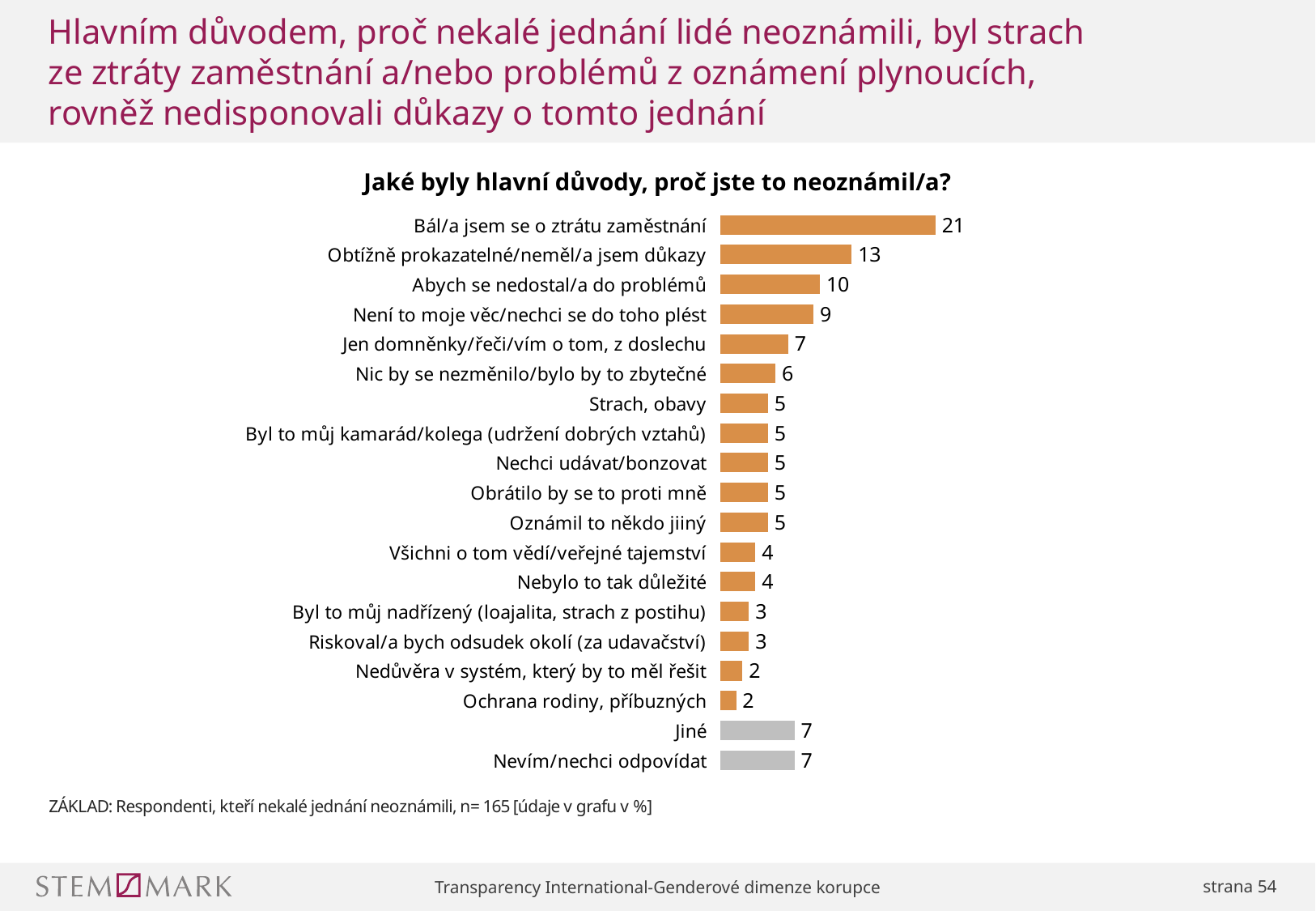
Which category has the highest value? Bál/a jsem se o ztrátu zaměstnání How many categories are shown in the chart? 19 What kind of chart is shown on the slide? bar chart What is the value for "Nevím/nechci odpovídat"? 7 What is the difference between the values for "Bál/a jsem se o ztrátu zaměstnání" and "Obtížně prokazatelné/neměl/a jsem důkazy"? 8 What is the value for "Obtížně prokazatelné/neměl/a jsem důkazy"? 13 What is the value for "Bál/a jsem se o ztrátu zaměstnání"? 21 Which is larger, the value for "Jen domněnky/řeči/vím o tom, z doslechu" or for "Nic by se nezměnilo/bylo by to zbytečné"? Jen domněnky/řeči/vím o tom, z doslechu What is the value for "Není to moje věc/nechci se do toho plést"? 9 What is the title of the chart? Jaké byly hlavní důvody, proč jste to neoznámil/a? What is the lowest value shown in the chart? 2 What colour are the bars for "Jiné" and "Nevím/nechci odpovídat"? grey